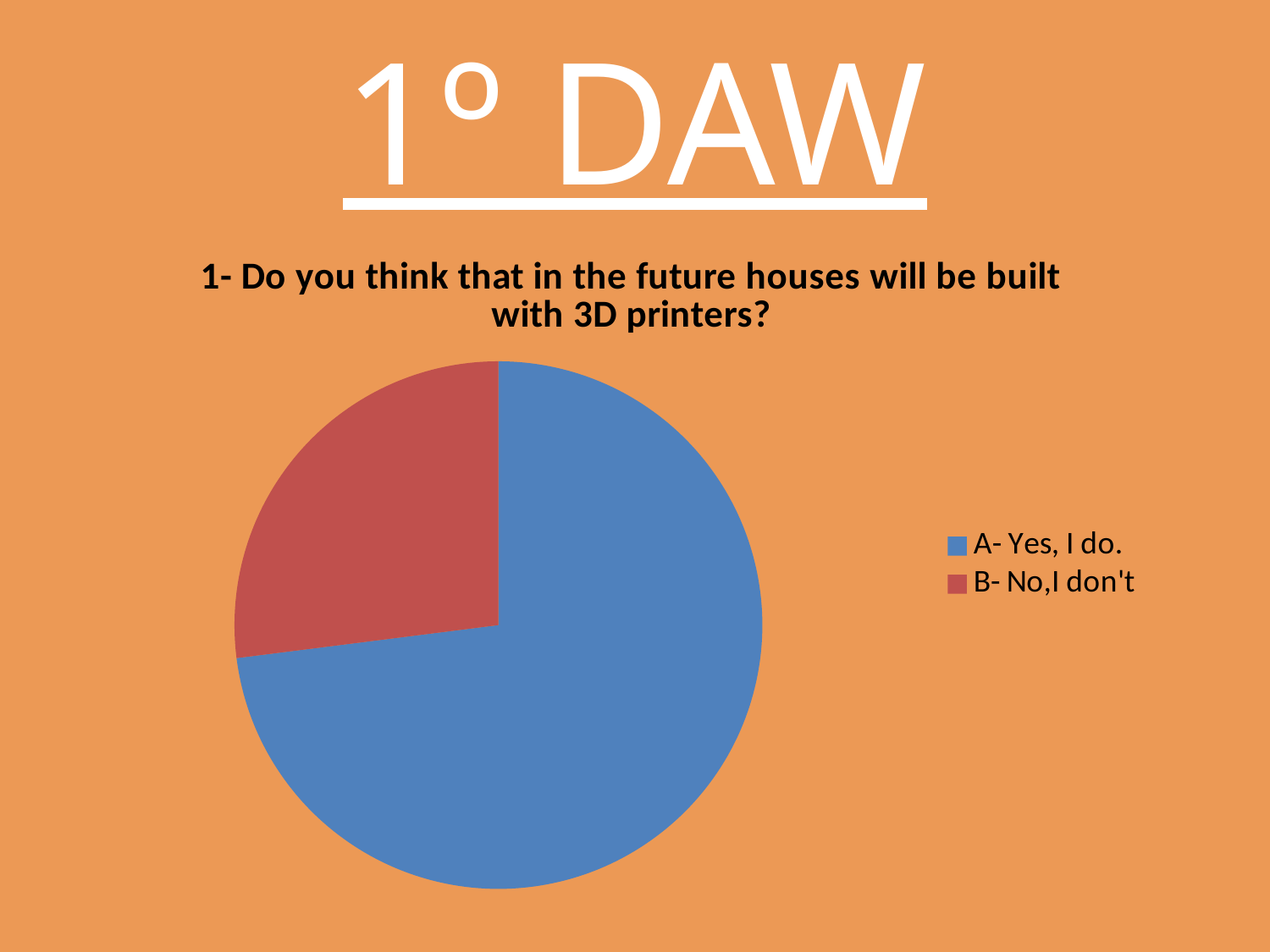
What kind of chart is shown on the slide? pie chart Which slice is larger in the pie chart, "A- Yes, I do." or "B- No,I don't"? A- Yes, I do. Which answer option has the largest slice in the pie chart? A- Yes, I do. What question is the pie chart about, according to the text above it? 1- Do you think that in the future houses will be built with 3D printers? How many entries does the legend of the pie chart list? 2 How many slices does the pie chart have? 2 Which answer option has the smallest slice in the pie chart? B- No,I don't What colour is the slice for "B- No,I don't" in the pie chart? red